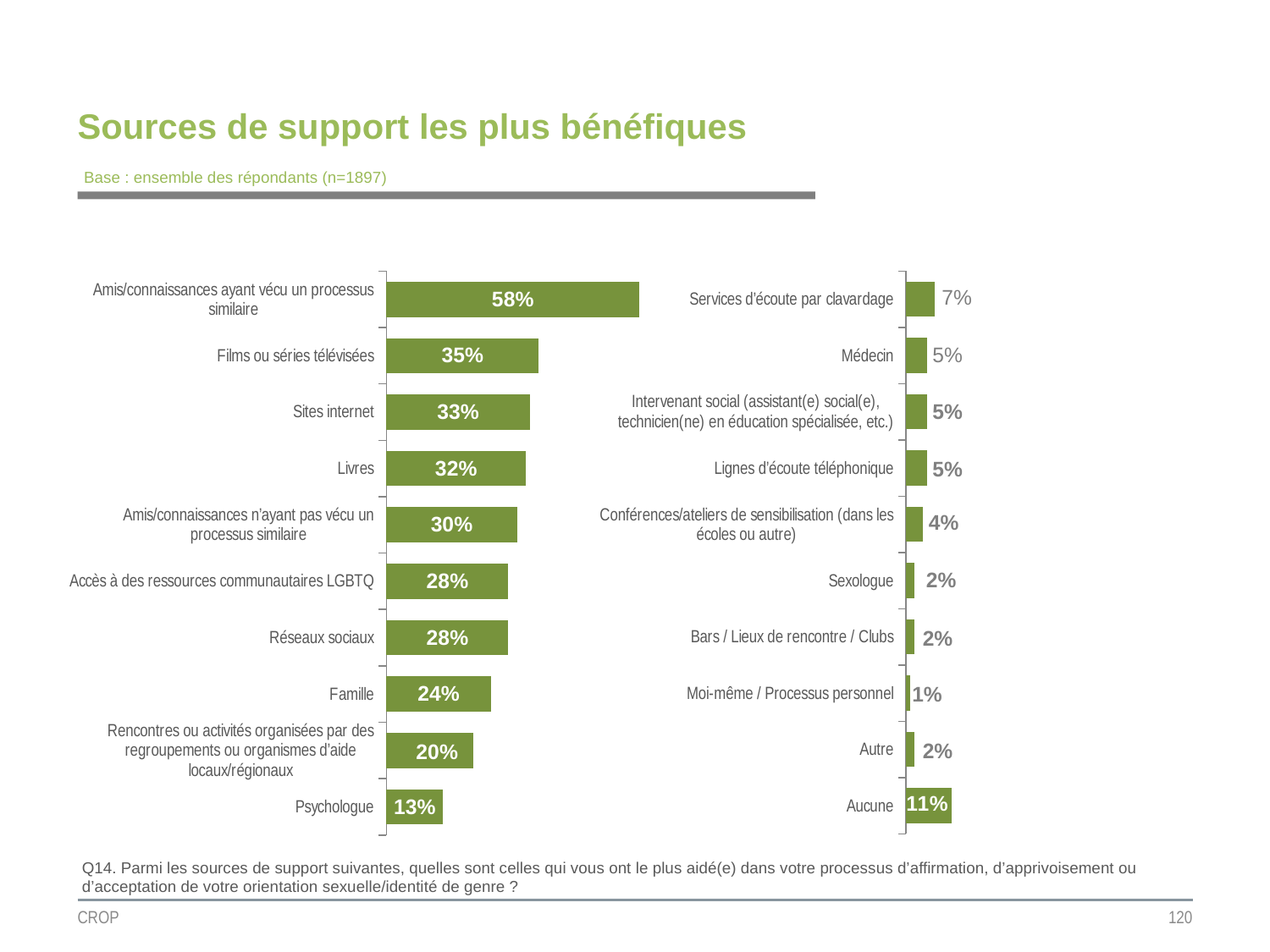
On the right chart, which category has the highest value? Aucune On the left chart, which is larger: Famille or Réseaux sociaux? Réseaux sociaux How many categories are shown on the left chart? 10 On the left chart, what is the difference between Sites internet and Livres? 1 percentage point On the right chart, which category has the lowest value? Moi-même / Processus personnel On the left chart, what is the value for Films ou séries télévisées? 35% On the right chart, what is the difference between Aucune and Services d'écoute par clavardage? 4 percentage points On the right chart, what is the value for Services d'écoute par clavardage? 7% What type of chart is used on this slide? Bar chart On the left chart, which category has the highest value? Amis/connaissances ayant vécu un processus similaire On the left chart, which category has the lowest value? Psychologue On the left chart, what is the value for Psychologue? 13%